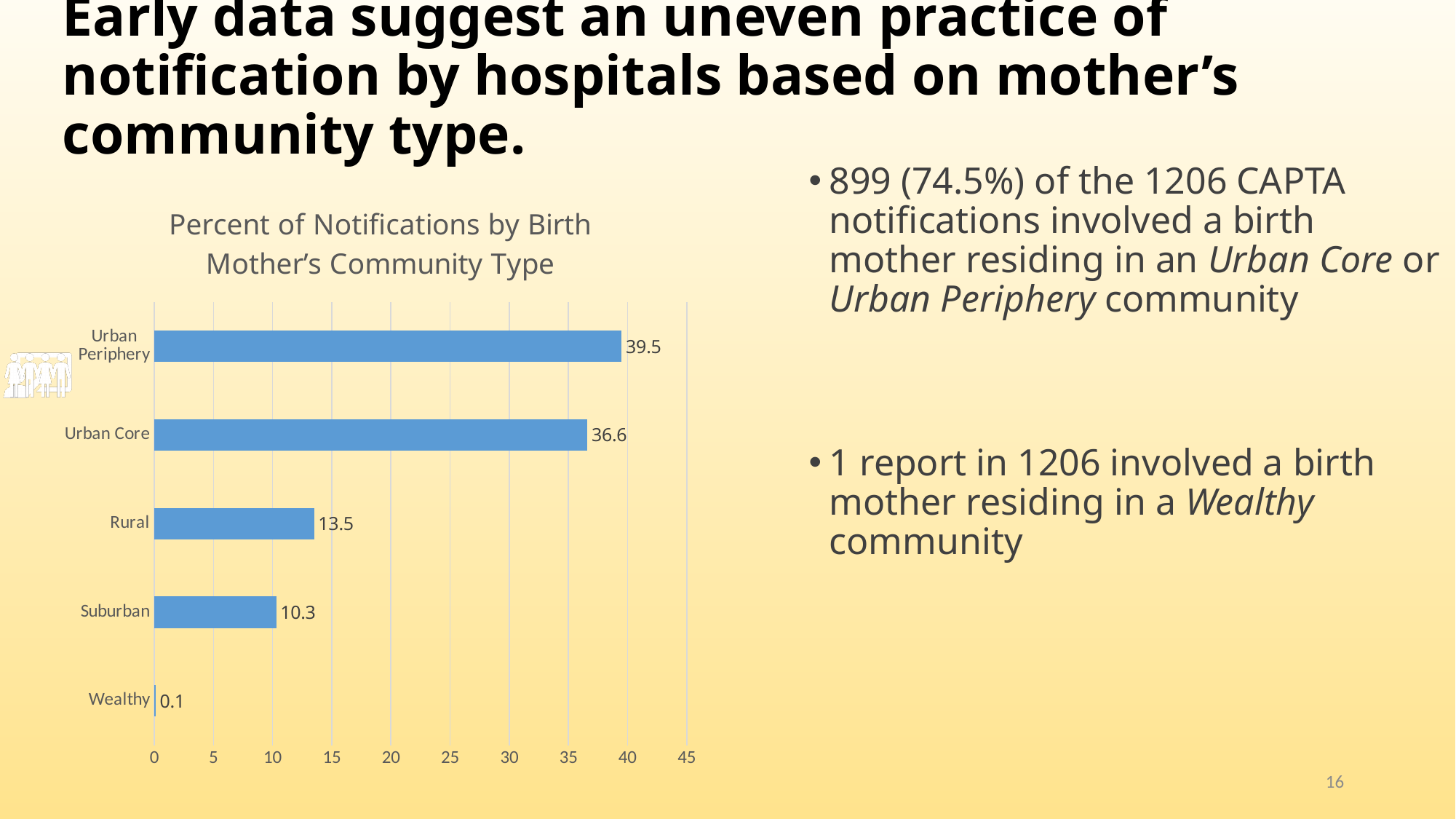
What is the value for Suburban? 10.3 What kind of chart is shown on the slide? Bar chart What is the value for Rural? 13.5 How many community types are shown in the chart? 5 What is the value for Urban Periphery? 39.5 Which community type has the lowest percent of notifications? Wealthy What is the title of the chart? Percent of Notifications by Birth Mother's Community Type Which community type has the highest percent of notifications? Urban Periphery What is the value for Wealthy? 0.1 Which is larger, the value for Rural or the value for Suburban? Rural What is the difference between the values for Urban Periphery and Urban Core? 2.9 What is the value for Urban Core? 36.6